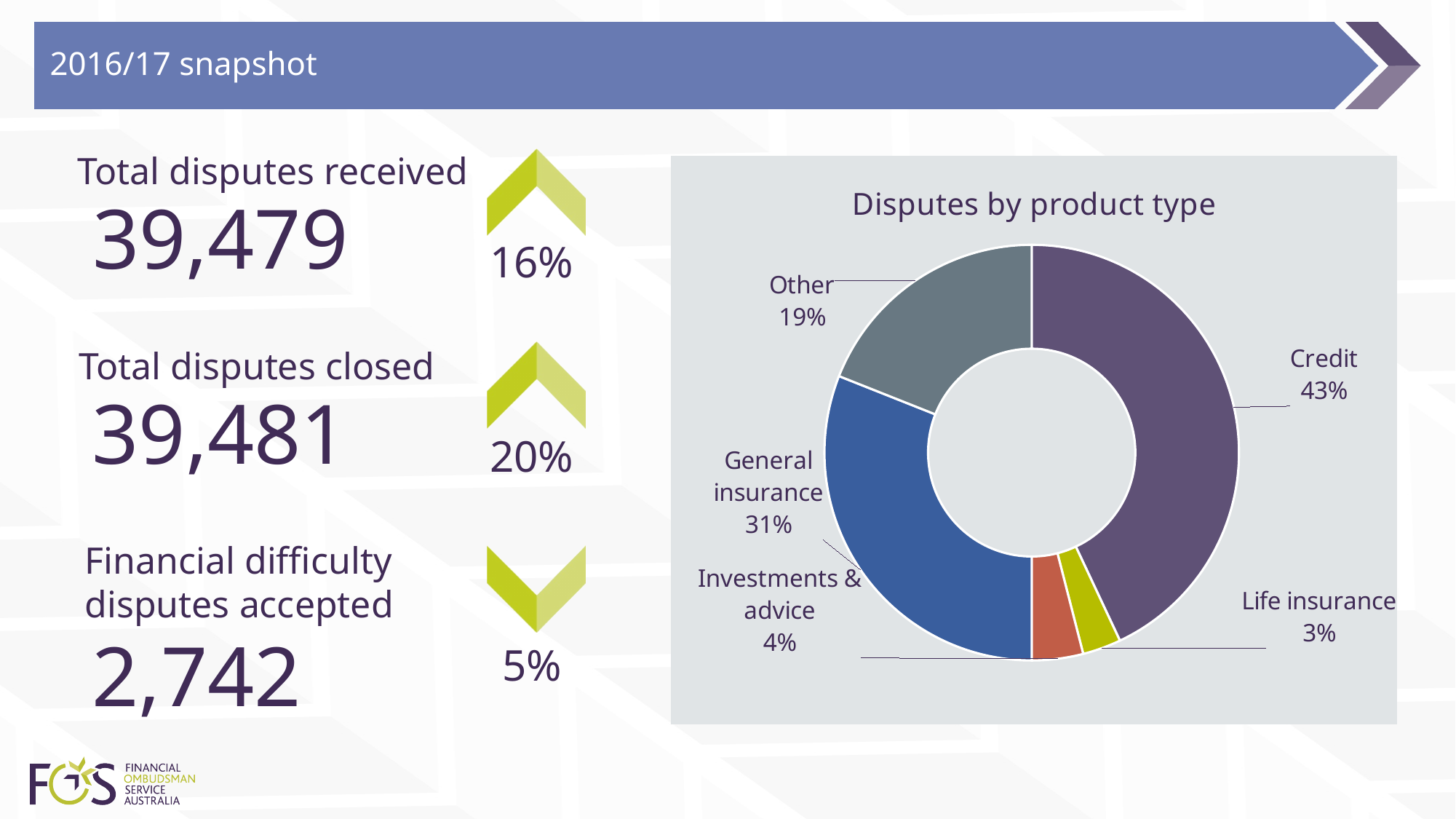
What kind of chart is 'Disputes by product type'? Pie chart (doughnut) In the 'Disputes by product type' chart, which has a larger share: Other or General insurance? General insurance In the 'Disputes by product type' chart, what share of disputes is Credit? 43% In the 'Disputes by product type' chart, how many percentage points larger is Credit's share than General insurance's share? 12 percentage points In the 'Disputes by product type' chart, what share of disputes is Investments & advice? 4% In the 'Disputes by product type' chart, what share of disputes is General insurance? 31% How many product type categories are shown in the 'Disputes by product type' chart? 5 Which product type has the largest share in the 'Disputes by product type' chart? Credit Which product type has the smallest share in the 'Disputes by product type' chart? Life insurance In the 'Disputes by product type' chart, what share of disputes is Other? 19% What is the title of the chart on the slide? Disputes by product type In the 'Disputes by product type' chart, what share of disputes is Life insurance? 3%